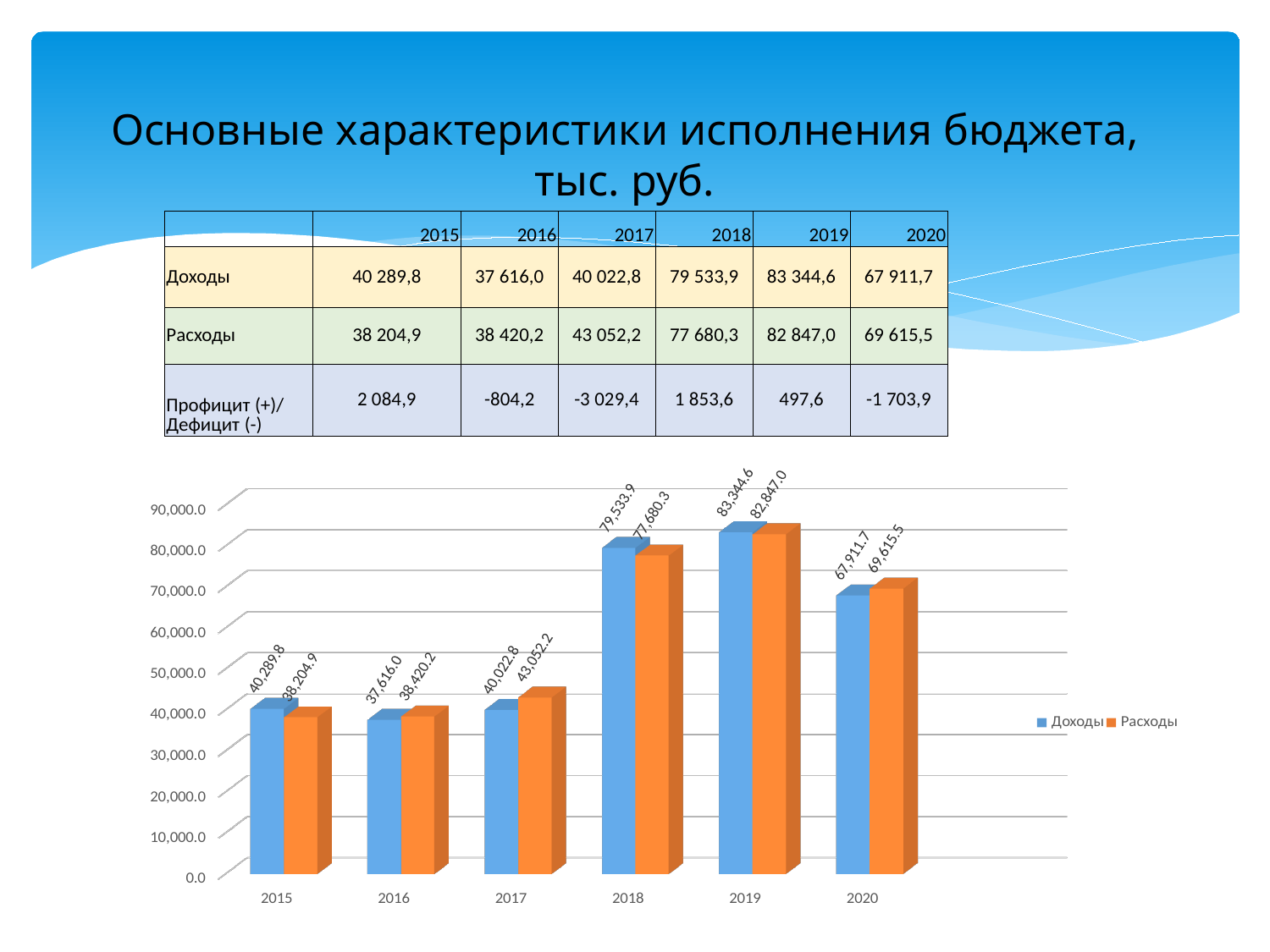
What is the value of Расходы for 2017 in the chart? 43,052.2 What type of chart is shown on the slide? bar chart In which year is Расходы lowest in the chart? 2015 What is the value of Доходы for 2020 in the chart? 67,911.7 In which year is Доходы highest in the chart? 2019 What is the difference between Доходы and Расходы in 2019 according to the chart labels? 497.6 Is the value of Расходы for 2020 greater or less than 70,000.0? less Which colour represents Расходы in the chart? orange What is the value of Доходы for 2015 in the chart? 40,289.8 How many series does the chart legend list? 2 How many years are shown on the x axis of the chart? 6 Which is larger in 2018, Доходы or Расходы? Доходы